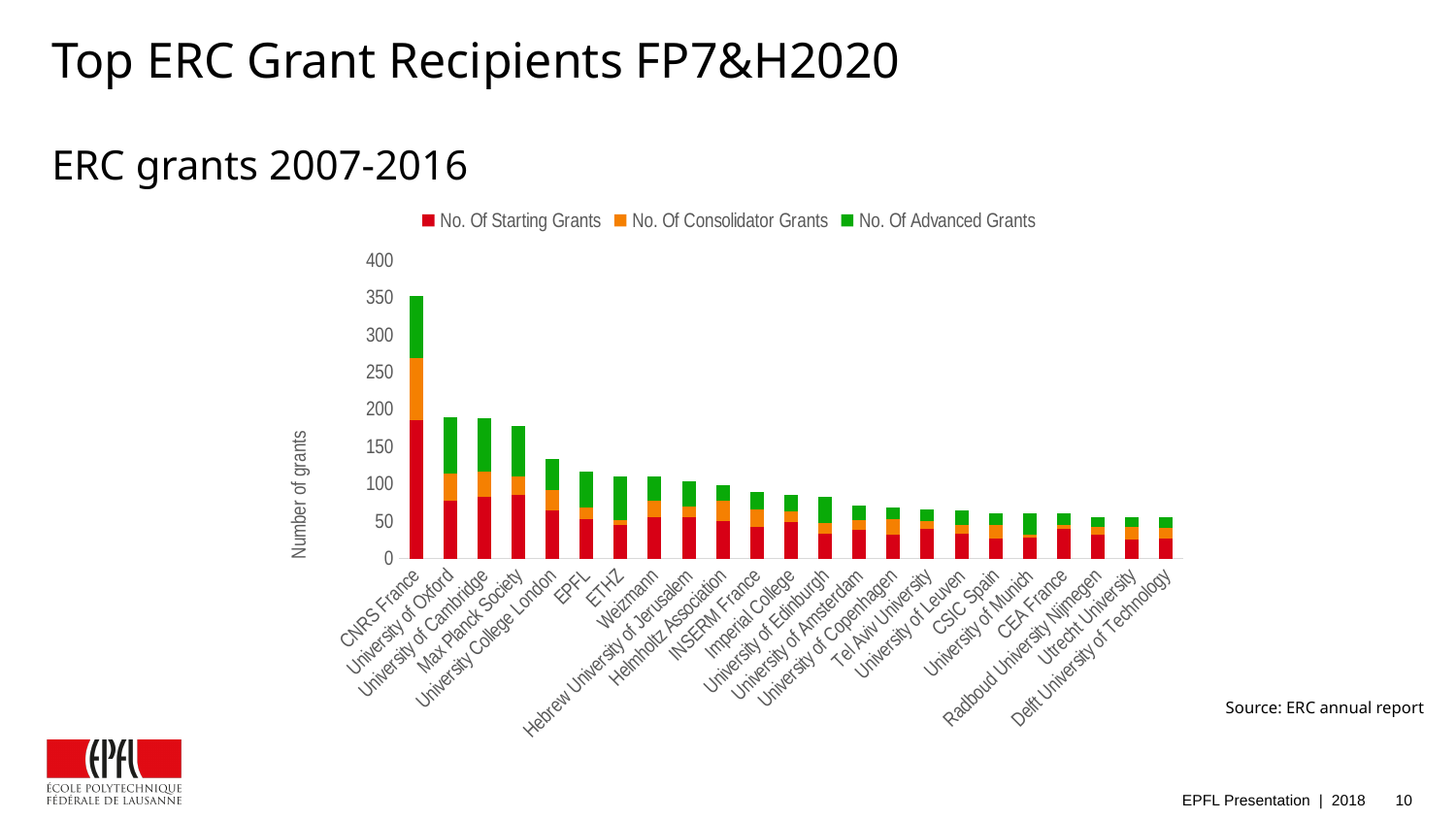
Which has more total ERC grants, CNRS France or University of Oxford? CNRS France Is the total number of grants for University of Oxford greater or less than 200? less How many series does the legend list? 3 What is the label on the vertical axis of the chart? Number of grants Which has more total ERC grants, EPFL or Utrecht University? EPFL Is the total number of grants for EPFL greater or less than 100? greater Do the total bar heights rise or fall moving from left to right along the x axis? fall What kind of chart is shown on the slide? Stacked bar chart How many institutions are shown on the x axis of the chart? 23 Is the total number of grants for CNRS France greater or less than 300? greater Which institution has the highest total number of ERC grants? CNRS France